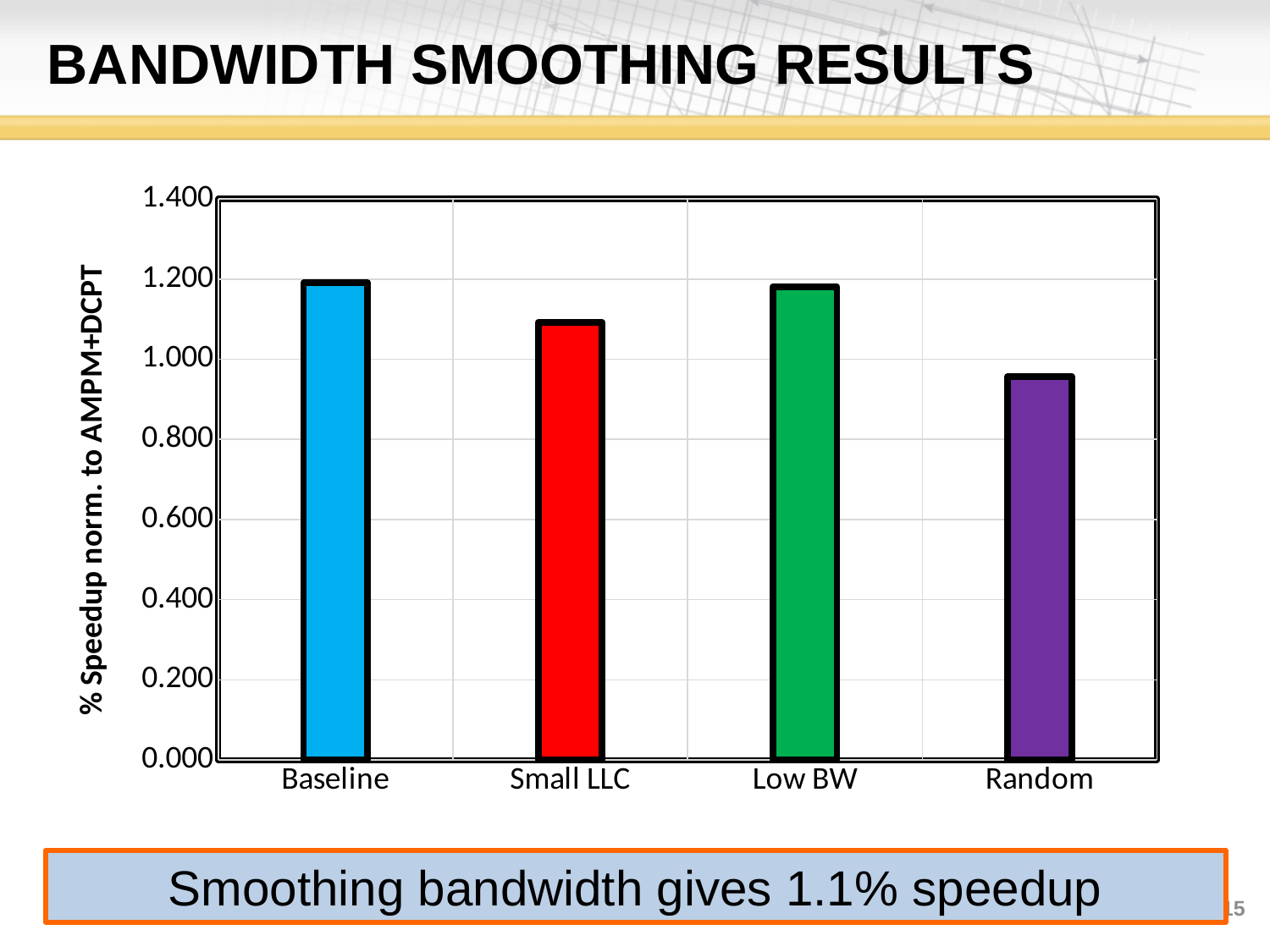
Is the value for Baseline greater or less than 1.000? greater Is the value for Random greater or less than 1.000? less Is the value for Random greater or less than 0.800? greater How many categories are plotted on the x axis? 4 What kind of chart is shown on the slide? bar chart Which is larger, the value for Baseline or the value for Small LLC? Baseline Which is larger, the value for Small LLC or the value for Random? Small LLC Which category has the lowest value? Random What colour is the bar for Random? purple What is the title of the y axis? % Speedup norm. to AMPM+DCPT